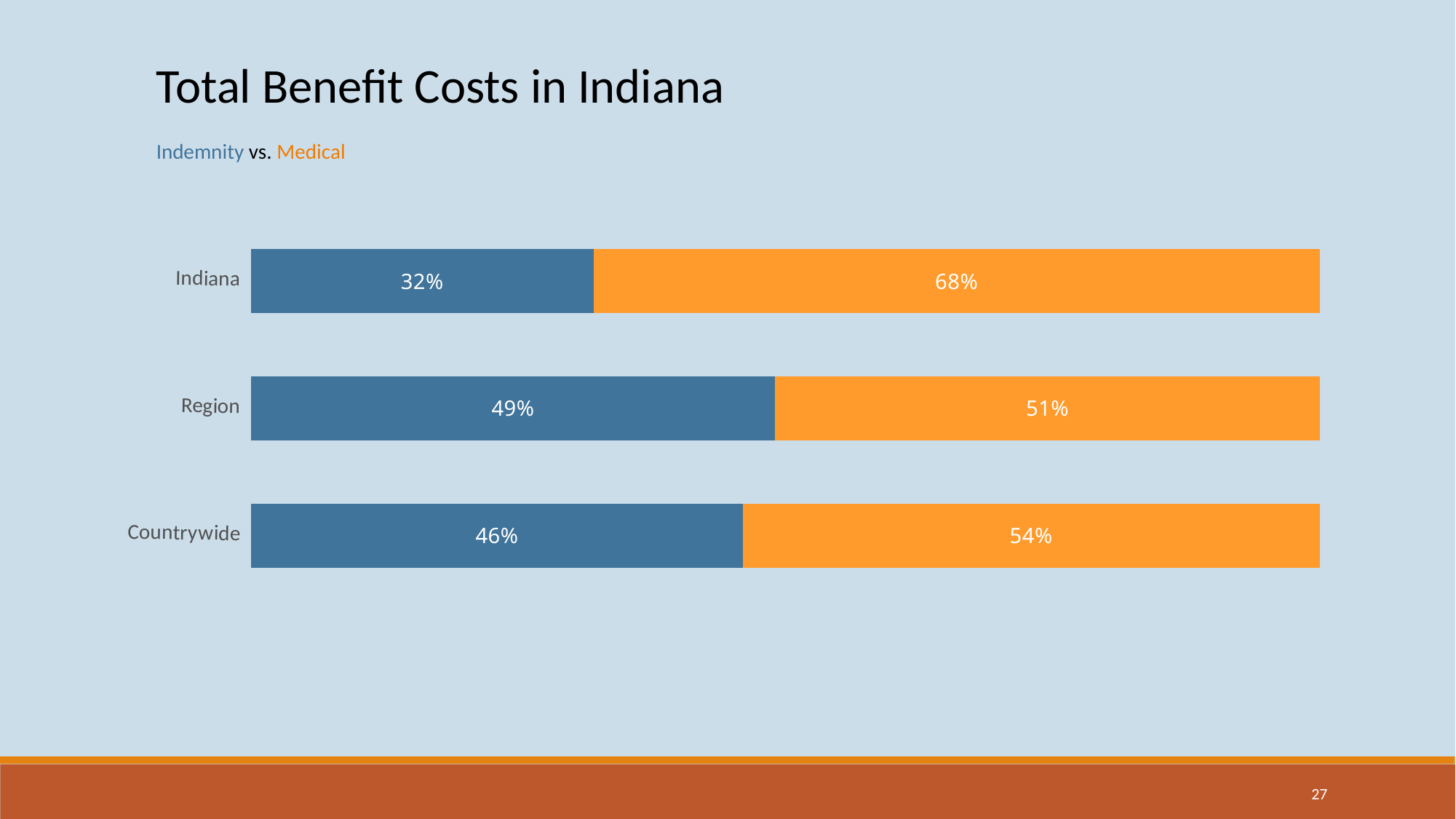
What is the Indemnity share for Indiana? 32% Which category has the highest Medical share? Indiana What kind of chart is shown on the slide? Stacked bar chart What is the Medical share for Indiana? 68% What is the total of the stacked bar for Region? 100% What is the Indemnity share for Region? 49% Which is larger for Countrywide, the Indemnity share or the Medical share? Medical What is the Medical share for Countrywide? 54% How many series does the chart show? 2 How many categories are shown on the chart? 3 What is the difference between the Medical and Indemnity shares for Indiana? 36% Which category has the lowest Indemnity share? Indiana